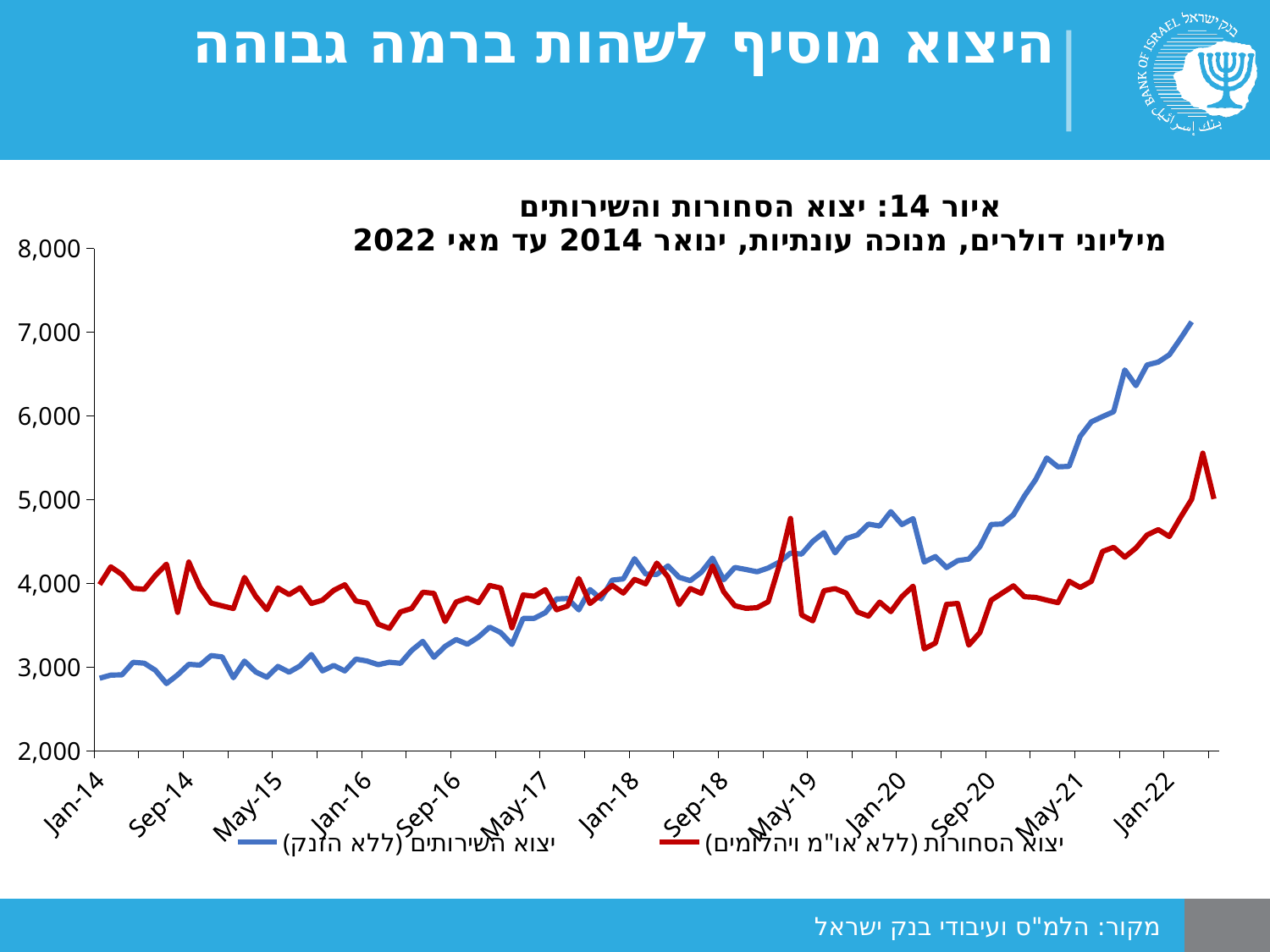
Is the value of the blue series (יצוא השירותים) at its last point (2022) greater or less than 7,000? greater What is the title of the chart (first line)? איור 14: יצוא הסחורות והשירותים At Jan-22, which series has the higher value, the blue (יצוא השירותים) or the red (יצוא הסחורות)? blue (יצוא השירותים) Is the value of the blue series (יצוא השירותים) at Jan-22 greater or less than 6,000? greater Does the blue series (יצוא השירותים) generally rise or fall from Jan-14 to 2022? rise Is the value of the blue series (יצוא השירותים) at Jan-14 greater or less than 3,000? less How many series does the legend list? 2 Which series is drawn in blue according to the legend? יצוא השירותים (ללא הזנק) What kind of chart is shown on the slide? line chart At Jan-14, which series has the higher value, the blue (יצוא השירותים) or the red (יצוא הסחורות)? red (יצוא הסחורות)